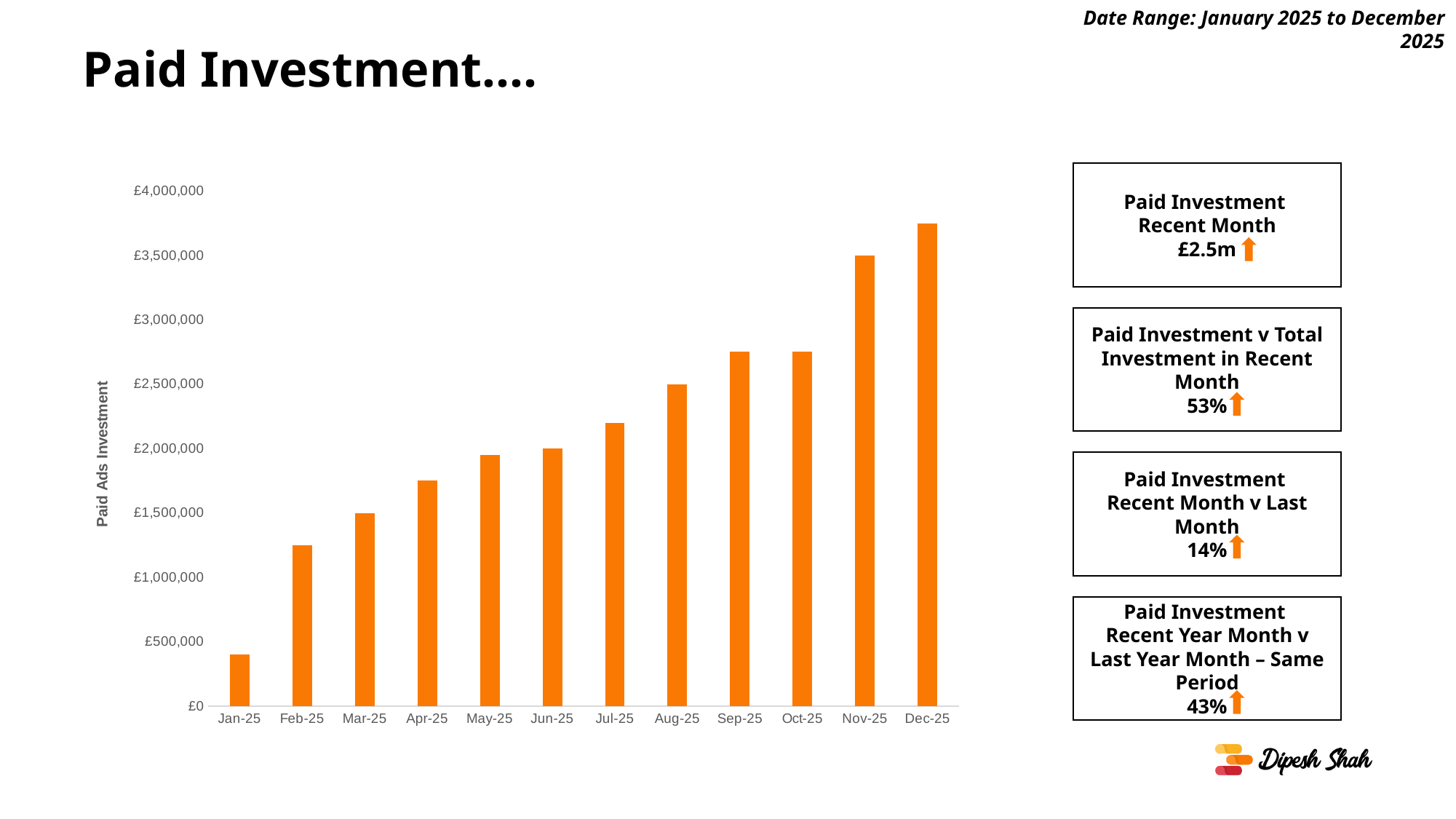
Which month has the highest paid ads investment? Dec-25 Which is larger, the value for Nov-25 or the value for Sep-25? Nov-25 What is the paid ads investment for Nov-25? £3,500,000 What is the paid ads investment for Aug-25? £2,500,000 Is the value for Jan-25 greater or less than £500,000? less Do the values generally rise or fall from Jan-25 to Dec-25? rise Which month has the lowest paid ads investment? Jan-25 What is the paid ads investment for Mar-25? £1,500,000 What is the title of the vertical axis of the chart? Paid Ads Investment Is the value for Dec-25 greater or less than £3,500,000? greater How many months are plotted on the x axis of the chart? 12 What kind of chart is shown on the slide? bar chart